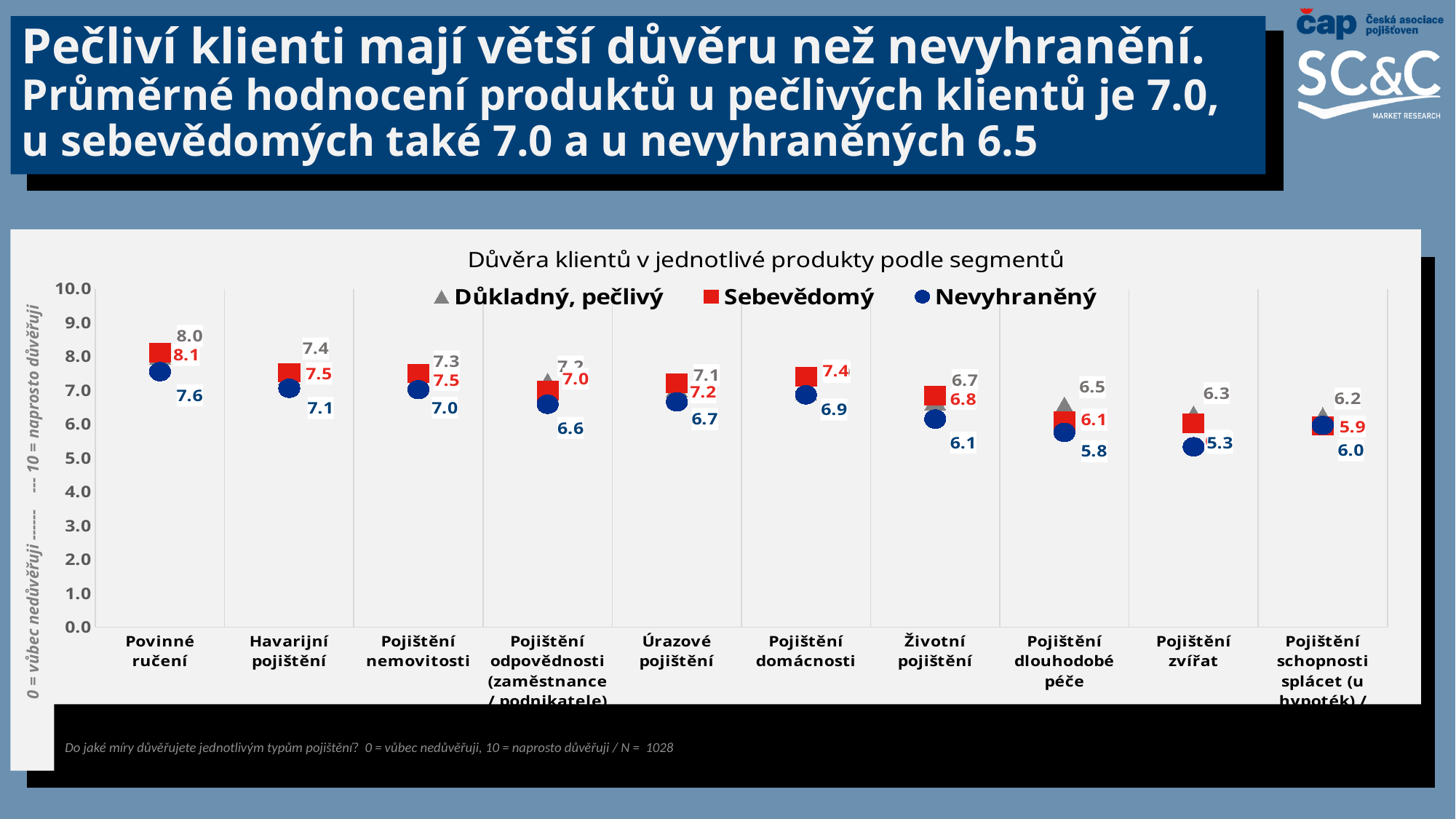
Which category has the highest value for the Sebevědomý series? Povinné ručení What is the value for Nevyhraněný for Pojištění zvířat? 5.3 Which category has the lowest value for the Nevyhraněný series? Pojištění zvířat Is the Sebevědomý value for Pojištění zvířat greater or less than 5.0? greater What is the title of the chart? Důvěra klientů v jednotlivé produkty podle segmentů How many product categories are shown on the x axis? 10 What is the value for Důkladný, pečlivý for Pojištění dlouhodobé péče? 6.5 What is the difference between the Sebevědomý and Nevyhraněný values for Životní pojištění? 0.7 For Pojištění dlouhodobé péče, which is larger: the Důkladný, pečlivý value or the Nevyhraněný value? Důkladný, pečlivý What is the value for Sebevědomý for Havarijní pojištění? 7.5 What is the value for Nevyhraněný for Povinné ručení? 7.6 How many series does the legend list? 3